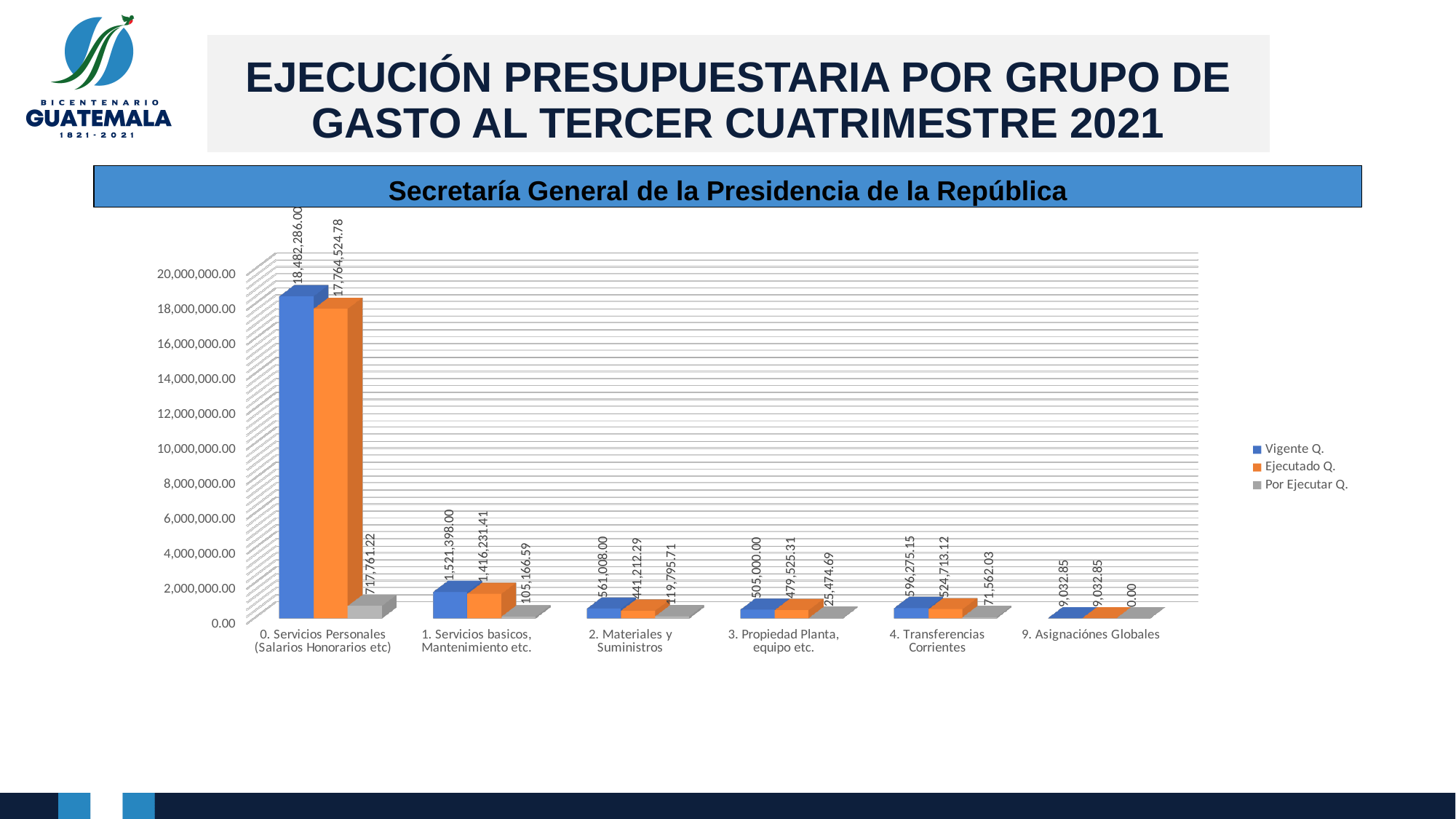
What is the Por Ejecutar Q. value for 2. Materiales y Suministros? 119,795.71 How many series does the legend list? 3 What is the Vigente Q. value for 0. Servicios Personales (Salarios Honorarios etc)? 18,482,286.00 Which category has the highest Vigente Q. value? 0. Servicios Personales (Salarios Honorarios etc) Which category has the lowest Ejecutado Q. value? 9. Asignaciónes Globales How many expense group categories are shown on the x axis? 6 What is the Ejecutado Q. value for 1. Servicios basicos, Mantenimiento etc.? 1,416,231.41 Is the Ejecutado Q. value for 0. Servicios Personales (Salarios Honorarios etc) greater or less than 16,000,000.00? greater Which is larger: the Vigente Q. value for 4. Transferencias Corrientes or for 2. Materiales y Suministros? 4. Transferencias Corrientes What is the Por Ejecutar Q. value for 9. Asignaciónes Globales? 0.00 What is the difference between the Vigente Q. and Ejecutado Q. values for 0. Servicios Personales (Salarios Honorarios etc)? 717,761.22 What kind of chart is shown on the slide? bar chart